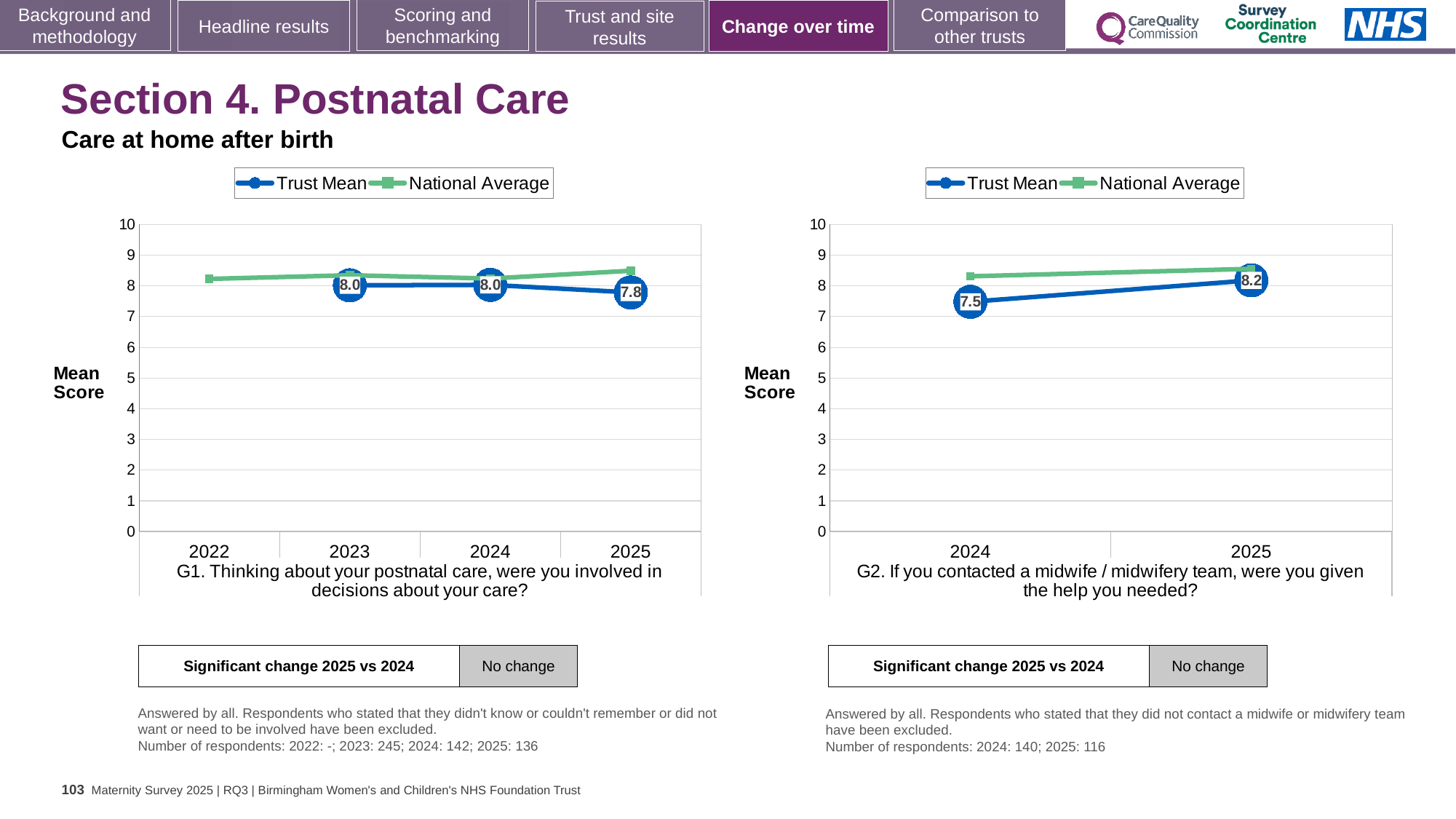
How many series does the legend of the right chart (G2) list? 2 In the left chart (G1), what is the Trust Mean score for 2023? 8.0 In the right chart (G2), by how much did the Trust Mean change from 2024 to 2025? 0.7 In the right chart (G2), does the Trust Mean rise or fall from 2024 to 2025? Rise In the right chart (G2), what is the Trust Mean score for 2024? 7.5 What type of chart is the left chart (G1)? Line chart In the left chart (G1), is the National Average for 2022 greater or less than 7? greater In the left chart (G1), which year has the lowest Trust Mean score? 2025 In the right chart (G2), which year has the higher Trust Mean score, 2024 or 2025? 2025 How many years are shown on the x axis of the left chart (G1)? 4 In the right chart (G2), what is the Trust Mean score for 2025? 8.2 In the left chart (G1), what is the Trust Mean score for 2025? 7.8